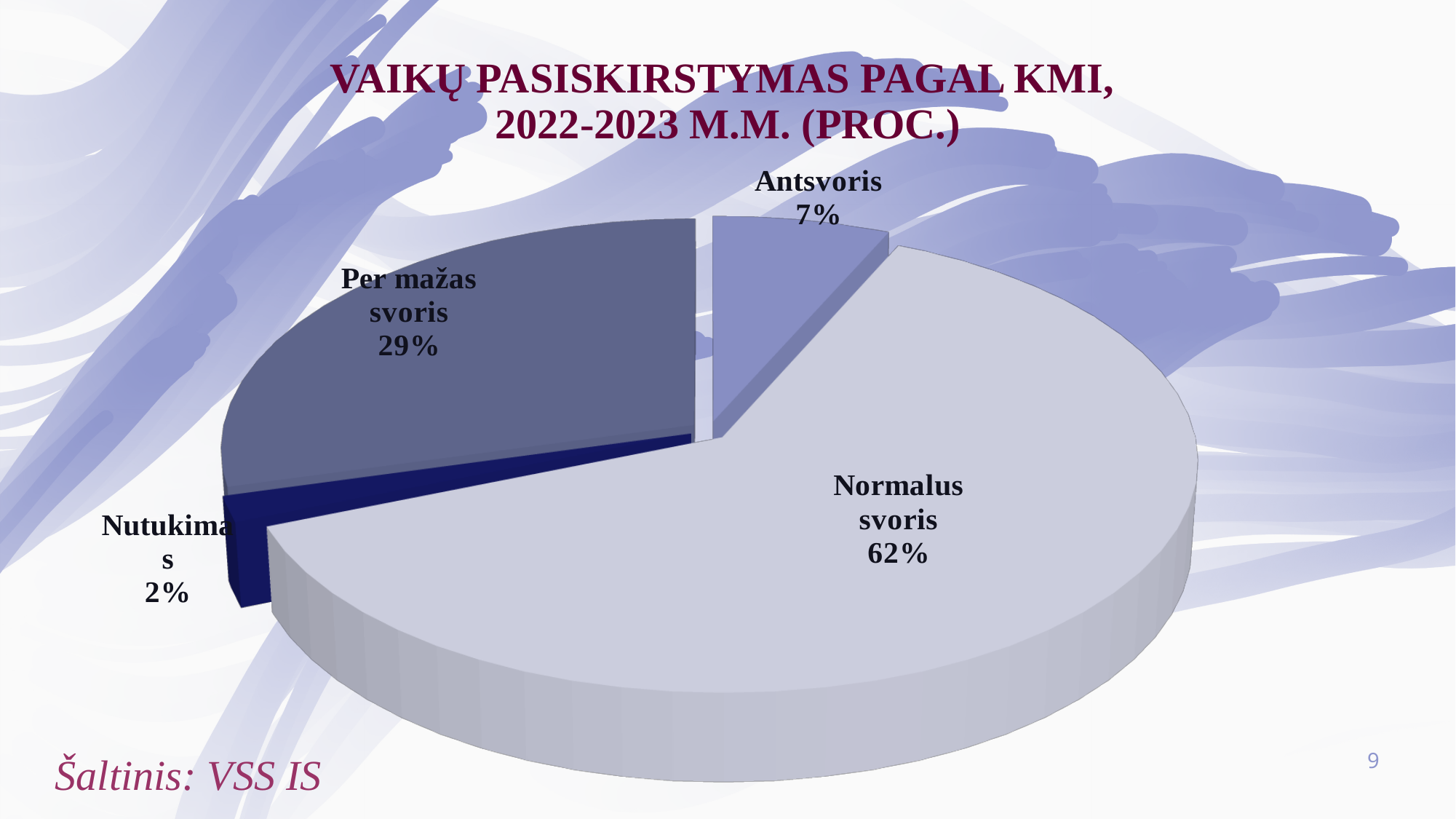
What percentage of children have normal weight (Normalus svoris)? 62% Which is larger, the share for Per mažas svoris or the share for Antsvoris? Per mažas svoris What percentage of children are overweight (Antsvoris)? 7% Which category has the largest share of the pie? Normalus svoris What is the difference in percentage points between Antsvoris and Nutukimas? 5 Which category has the smallest share of the pie? Nutukimas What is the title of the chart? VAIKŲ PASISKIRSTYMAS PAGAL KMI, 2022-2023 M.M. (PROC.) What type of chart is shown on the slide? Pie chart How many categories are shown in the pie chart? 4 What percentage of children are underweight (Per mažas svoris)? 29% What is the difference in percentage points between Normalus svoris and Per mažas svoris? 33 What percentage of children are obese (Nutukimas)? 2%